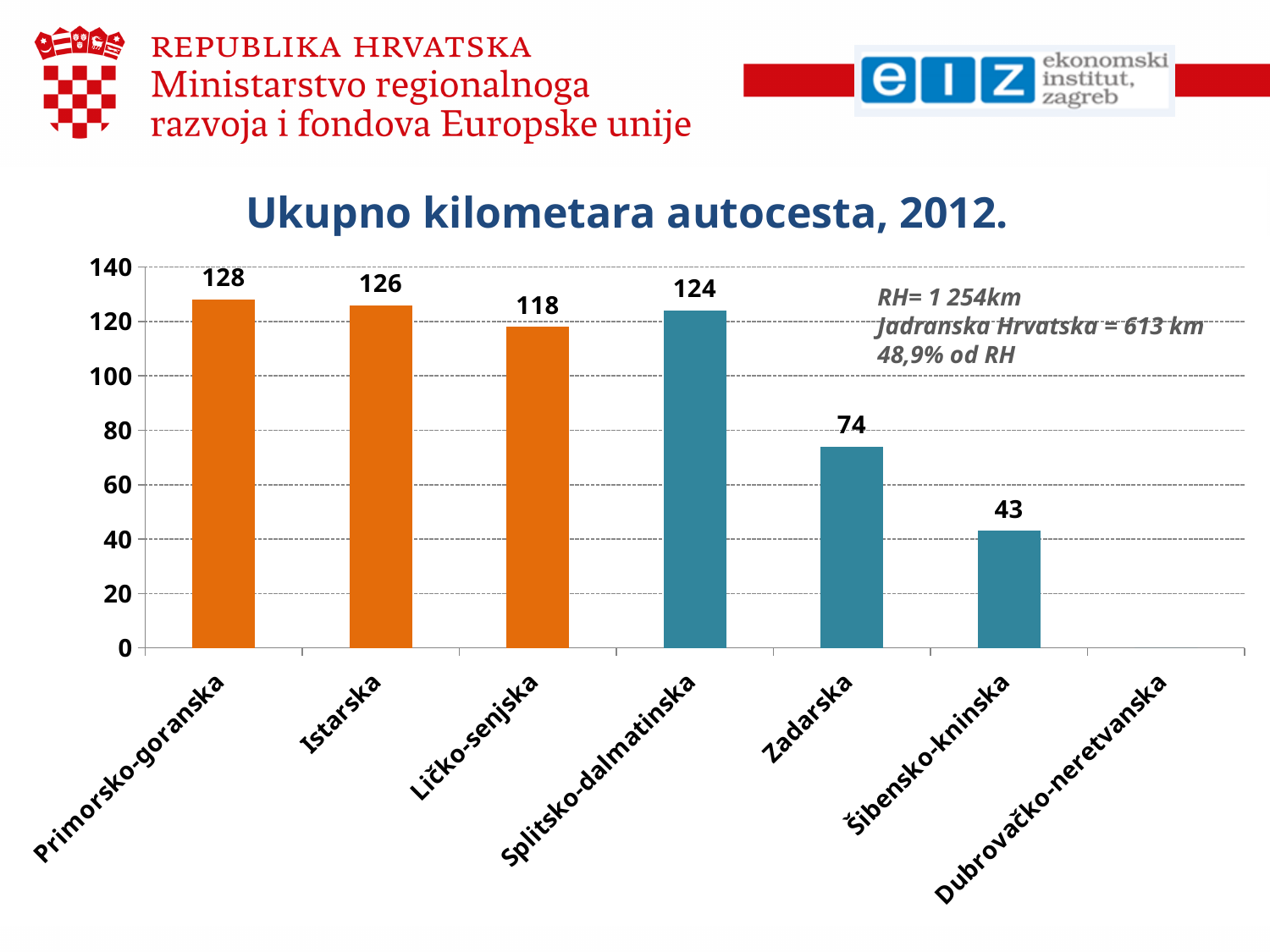
What kind of chart is shown on the slide? bar chart What is the value for Šibensko-kninska? 43 What is the value for Zadarska? 74 Do the values generally rise or fall from left to right along the x axis? fall What is the value for Primorsko-goranska? 128 How many categories are shown on the x axis? 7 Which is larger, the value for Istarska or the value for Splitsko-dalmatinska? Istarska What is the difference between the values for Primorsko-goranska and Šibensko-kninska? 85 Which category has the highest value? Primorsko-goranska Is the value for Zadarska greater or less than 80? less What is the title of the chart? Ukupno kilometara autocesta, 2012. What is the difference between the values for Splitsko-dalmatinska and Zadarska? 50